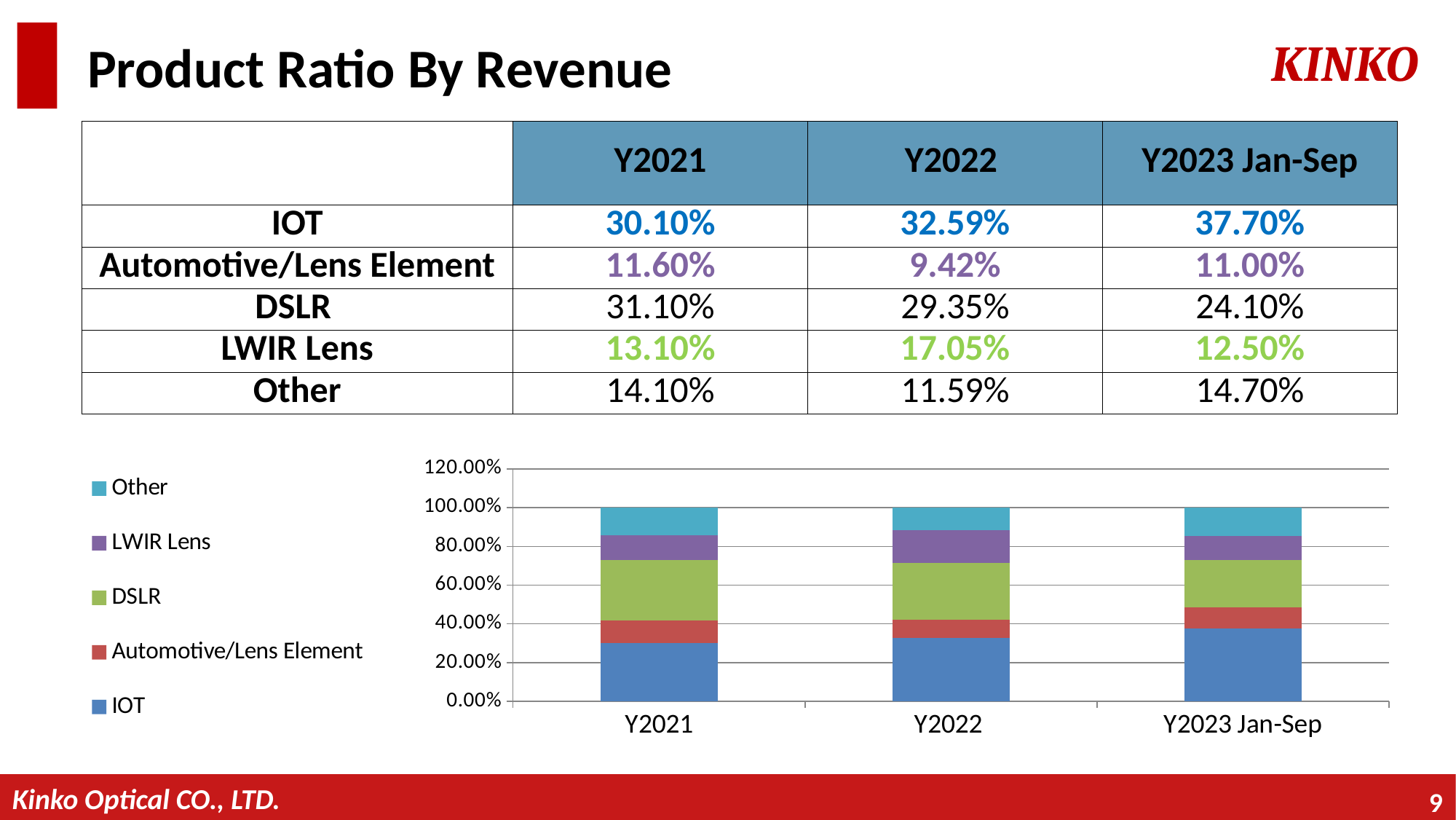
How many series does the chart legend list? 5 Does the IOT share of revenue rise or fall from Y2021 to Y2023 Jan-Sep? rise What is the IOT share of revenue for Y2023 Jan-Sep? 37.70% Which is larger in Y2021, the DSLR share or the IOT share? DSLR What is the DSLR share of revenue for Y2022? 29.35% What kind of chart is shown on the slide? stacked bar chart How many periods (bars) are shown on the x axis of the chart? 3 Is the IOT segment of the Y2023 Jan-Sep bar greater or less than 20.00%? greater What is the LWIR Lens share of revenue for Y2021? 13.10% In which period is the Automotive/Lens Element share of revenue lowest? Y2022 What is the difference between the IOT share in Y2023 Jan-Sep and in Y2021? 7.60% In which period is the IOT share of revenue highest? Y2023 Jan-Sep